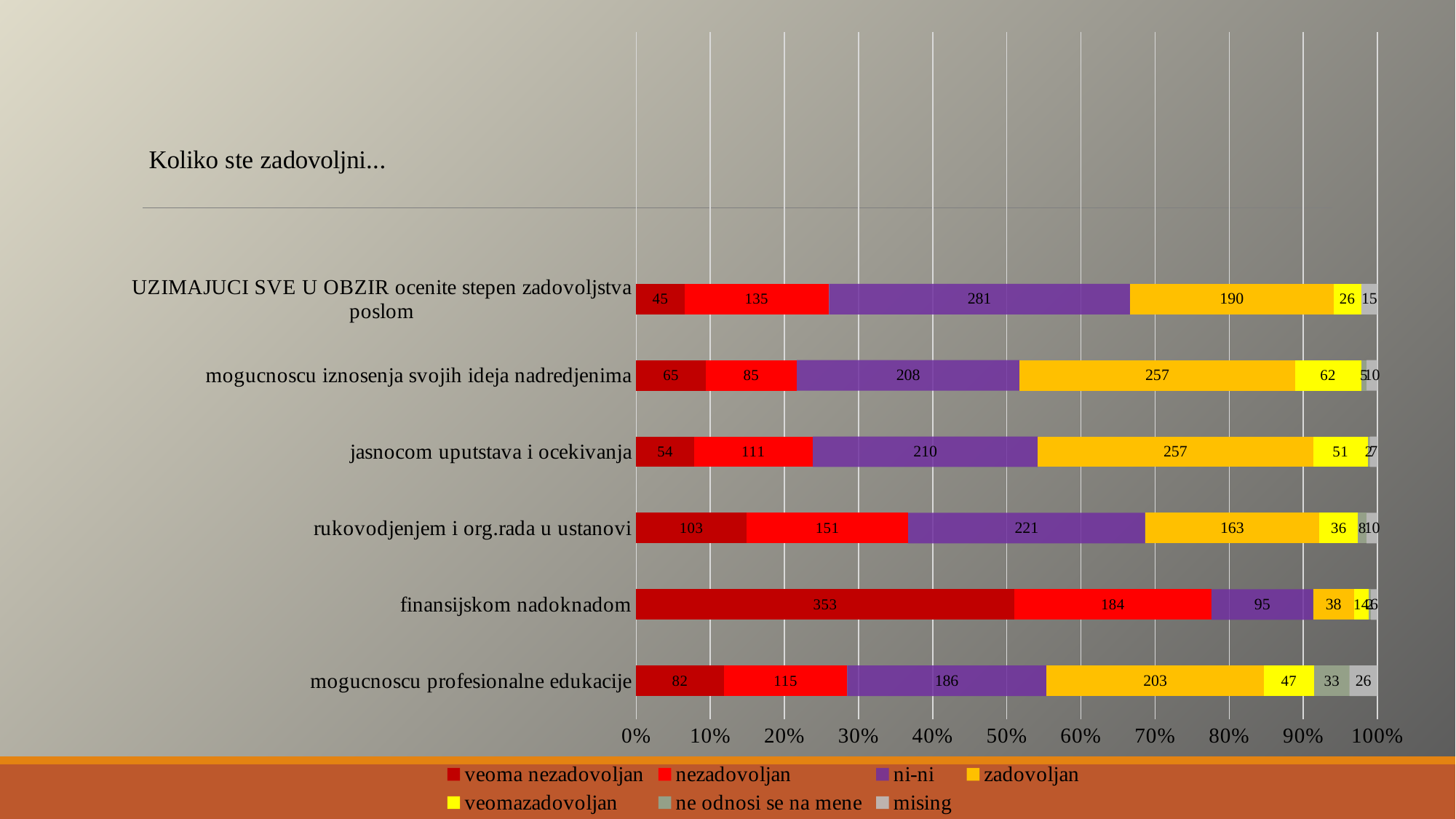
What is the 'ni-ni' value for 'UZIMAJUCI SVE U OBZIR ocenite stepen zadovoljstva poslom'? 281 How many series does the legend list? 7 What is the total of all segments in the bar for 'mogucnoscu profesionalne edukacije'? 692 How many categories (questions) are plotted on the chart? 6 Which category has the highest 'veoma nezadovoljan' value? finansijskom nadoknadom What is the difference between the 'veoma nezadovoljan' and 'nezadovoljan' values for 'finansijskom nadoknadom'? 169 What is the 'zadovoljan' value for 'mogucnoscu profesionalne edukacije'? 203 What is the title of the chart? Koliko ste zadovoljni... What is the 'veoma nezadovoljan' value for 'finansijskom nadoknadom'? 353 Which category has the highest 'ni-ni' value? UZIMAJUCI SVE U OBZIR ocenite stepen zadovoljstva poslom What kind of chart is shown on the slide? Stacked bar chart Which has the larger 'nezadovoljan' value: 'rukovodjenjem i org.rada u ustanovi' or 'finansijskom nadoknadom'? finansijskom nadoknadom